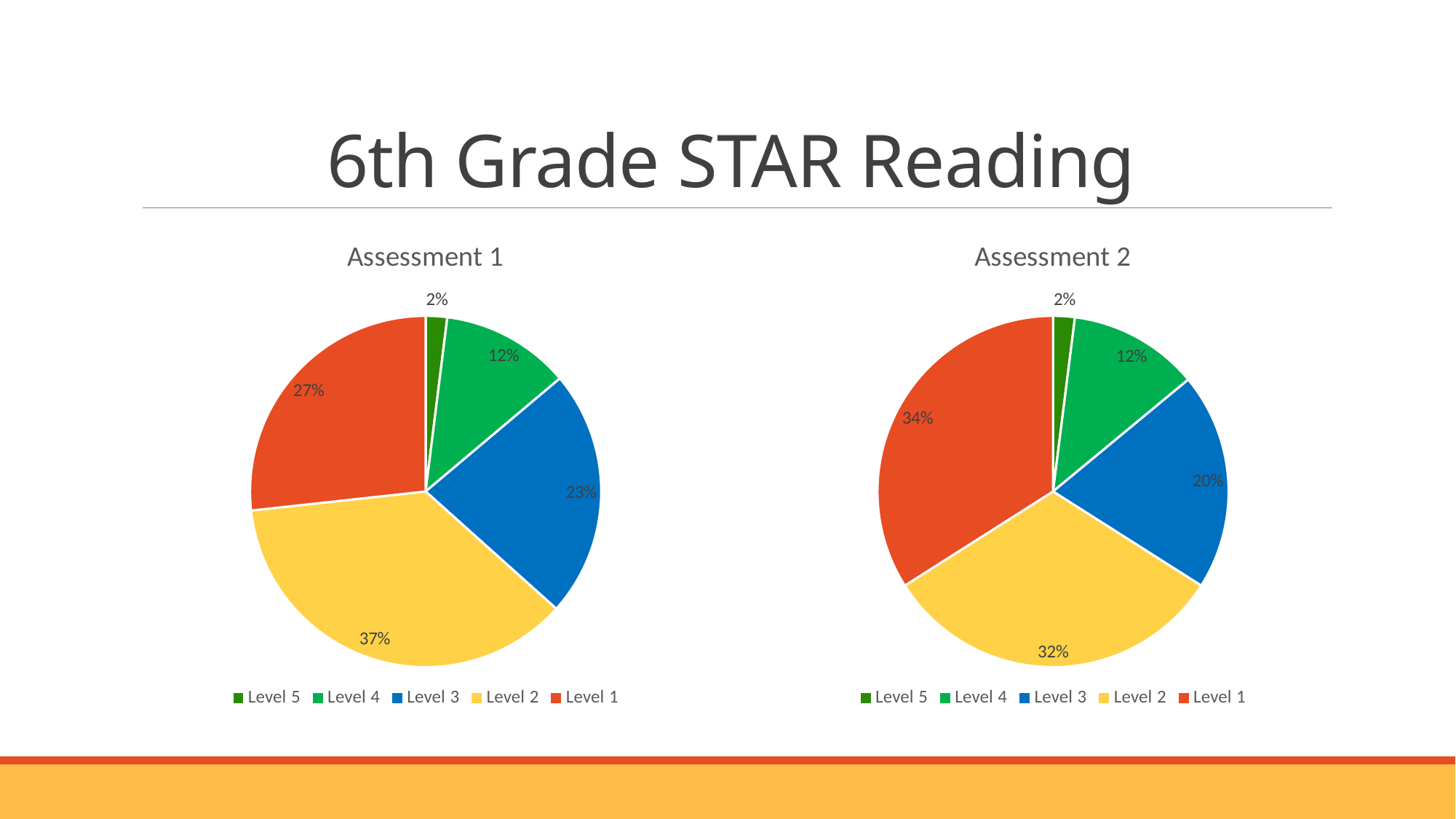
In the Assessment 1 chart, which level has the largest slice? Level 2 How many categories does the Assessment 1 chart show? 5 What kind of chart is the Assessment 2 chart? Pie chart In the Assessment 1 chart, what colour is the Level 1 slice? Red In the Assessment 1 chart, what is the value for Level 3? 23% In the Assessment 1 chart, what is the difference between Level 2 and Level 1? 10% What is the difference between the Level 1 share in Assessment 2 and the Level 1 share in Assessment 1? 7% In the Assessment 1 chart, what share of the pie is Level 2? 37% In the Assessment 2 chart, which level has the smallest slice? Level 5 In the Assessment 2 chart, which is larger, Level 1 or Level 2? Level 1 In the Assessment 2 chart, what share of the pie is Level 1? 34% In the Assessment 2 chart, what is the value for Level 3? 20%